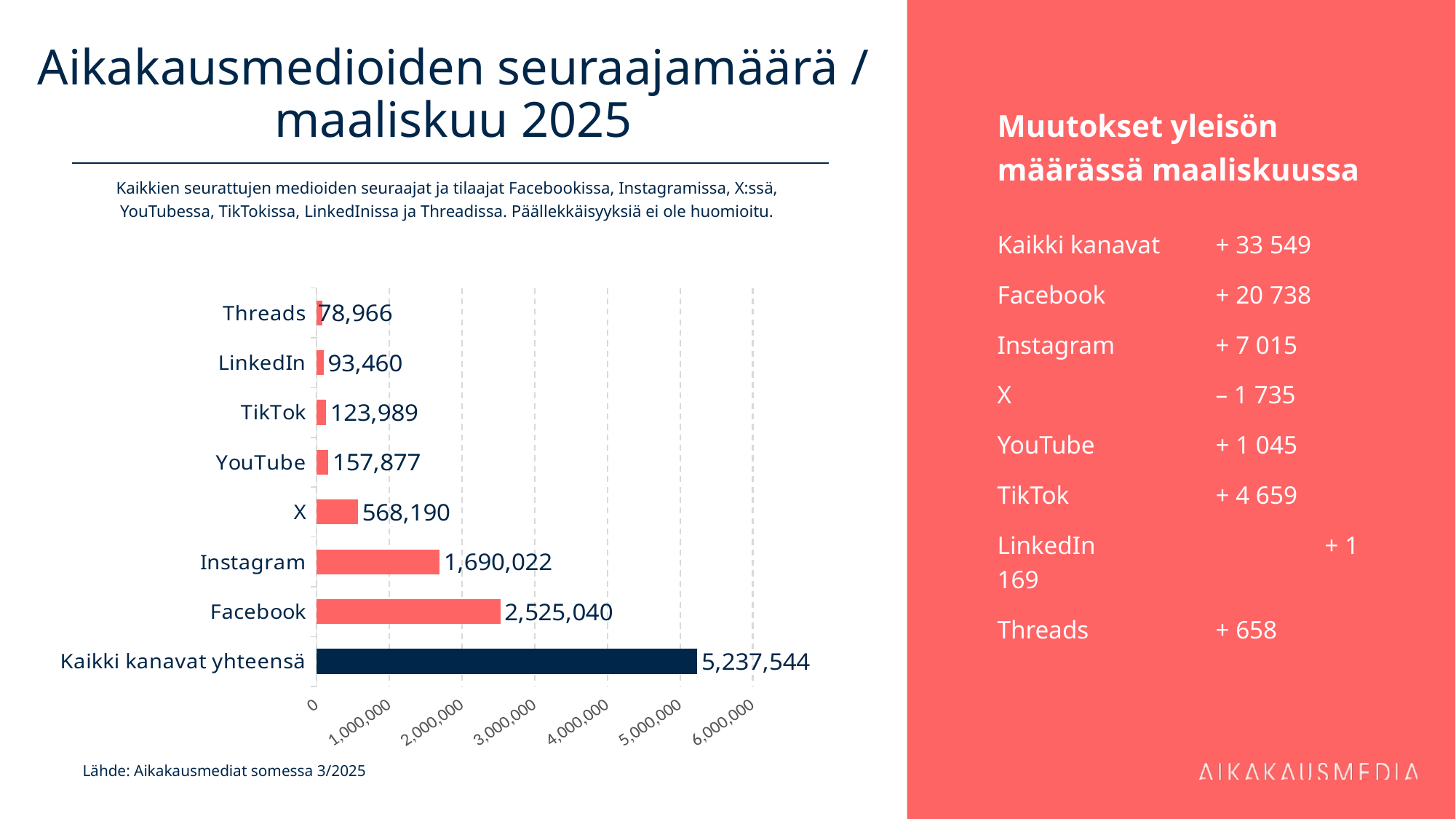
What kind of chart is shown on the slide? bar chart Which is larger, the value for TikTok or the value for LinkedIn? TikTok What is the value for Threads in the chart? 78,966 How many categories are shown in the chart? 8 What is the difference between the values for X and YouTube? 410,313 What is the value for Kaikki kanavat yhteensä in the chart? 5,237,544 What is the difference between the values for Facebook and Instagram? 835,018 What is the value for Instagram in the chart? 1,690,022 Is the value for X greater or less than 1,000,000? less Which category has the highest value in the chart? Kaikki kanavat yhteensä Which category has the lowest value in the chart? Threads What is the value for Facebook in the chart? 2,525,040